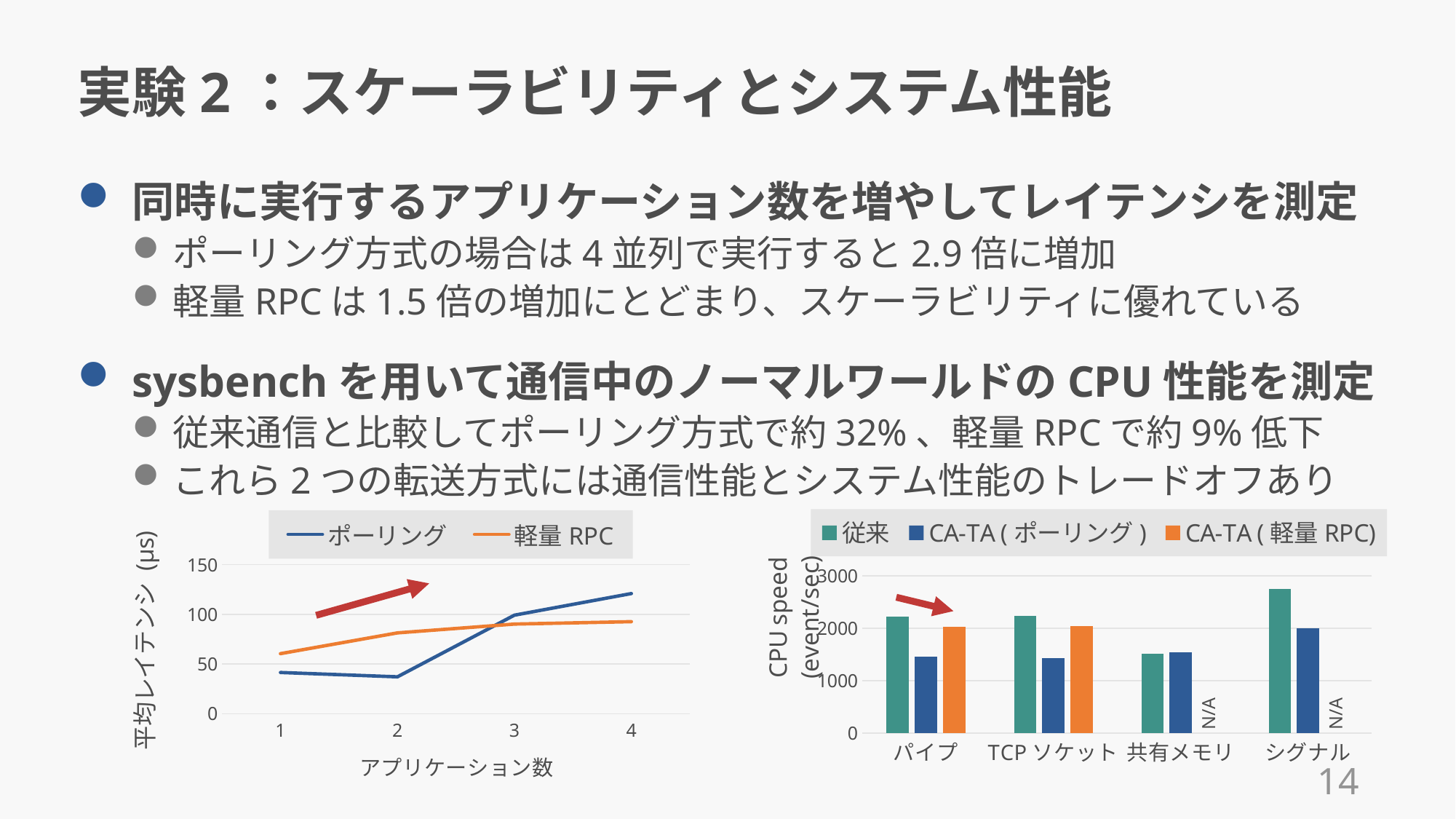
In the left chart, at アプリケーション数 4, which series has the higher latency, ポーリング or 軽量 RPC? ポーリング In the right chart, is the 従来 value for 共有メモリ greater or less than 2000? less In the left chart, how many series does the legend list? 2 In the left chart, is the ポーリング value at アプリケーション数 4 greater or less than 100? greater In the left chart, how many values of アプリケーション数 are plotted on the x axis? 4 In the right chart, which category has the highest 従来 value? シグナル In the right chart, how many series does the legend list? 3 What kind of chart is the right chart (CPU speed)? bar chart What kind of chart is the left chart (平均レイテンシ vs アプリケーション数)? line chart In the left chart, is the 軽量 RPC value at アプリケーション数 1 greater or less than 50? greater In the right chart, how many categories are shown on the x axis? 4 In the left chart, does the 軽量 RPC line rise or fall as アプリケーション数 increases from 1 to 4? rise